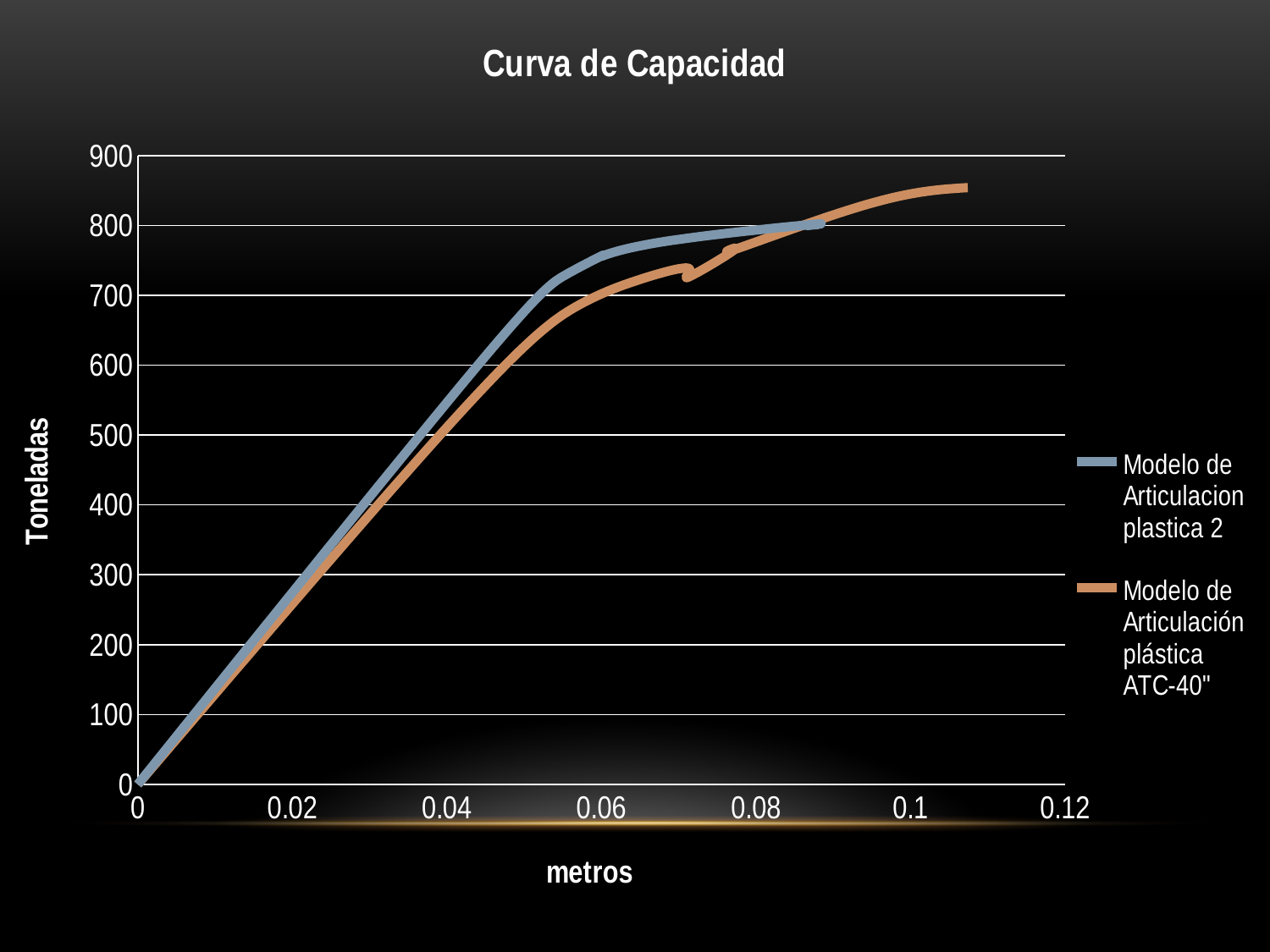
Is the value of 'Modelo de Articulacion plastica 2' at 0.06 metros greater or less than 700? greater Is the value of 'Modelo de Articulación plástica ATC-40"' at 0.1 metros greater or less than 800? greater What is the label of the vertical axis? Toneladas What is the title of the chart? Curva de Capacidad Is the highest value reached by 'Modelo de Articulación plástica ATC-40"' greater or less than 800? greater What kind of chart is shown on the slide? line chart Do the values of the 'Modelo de Articulacion plastica 2' series rise or fall as metros increases? rise What is the value in Toneladas of both series at 0 metros? 0 How many series does the legend list? 2 Which series extends further along the metros axis? Modelo de Articulación plástica ATC-40" Which series reaches the higher maximum value in Toneladas? Modelo de Articulación plástica ATC-40"